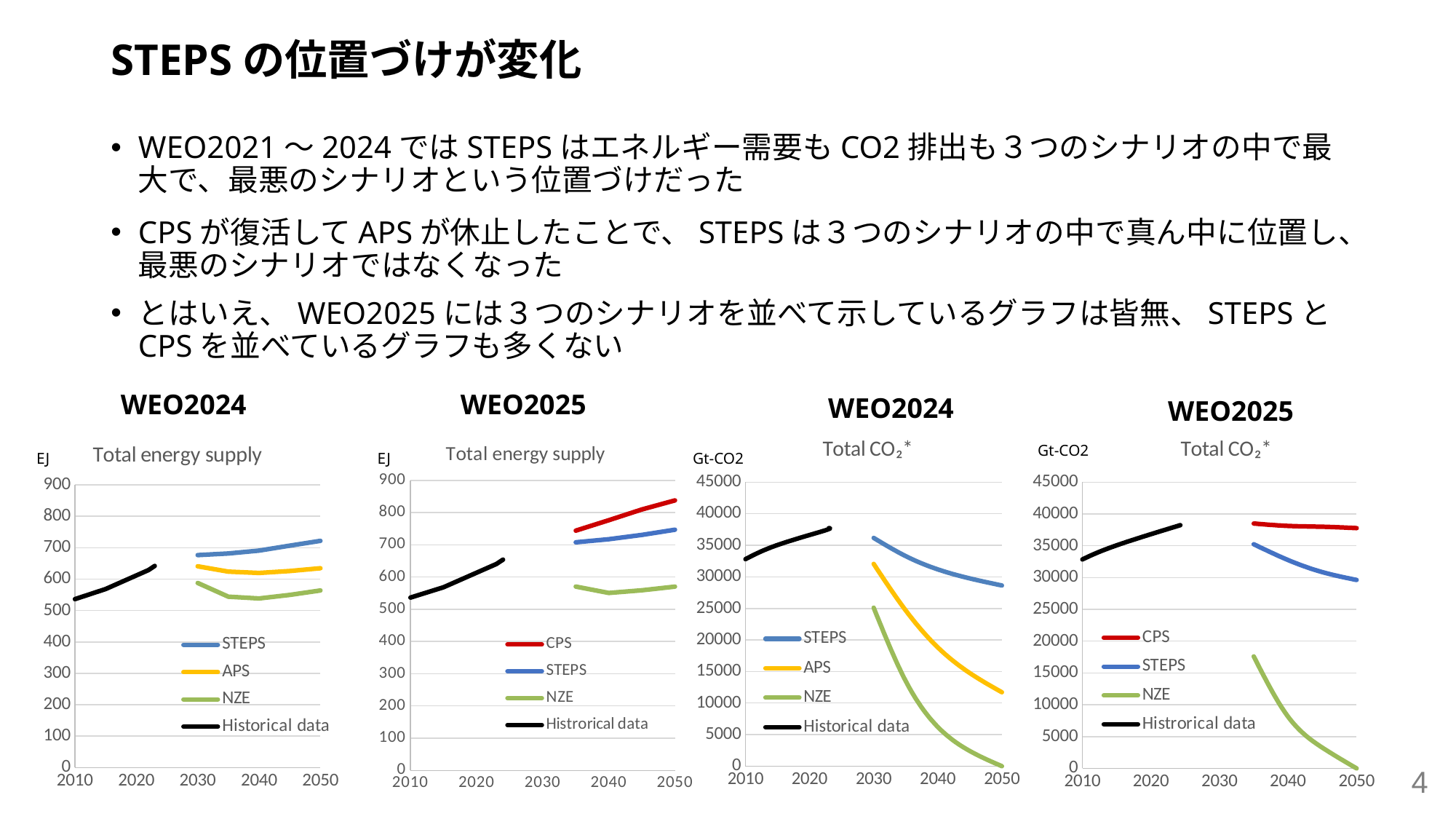
What kind of chart is the WEO2024 Total energy supply chart? line chart In the WEO2024 Total CO₂ chart, does the STEPS series rise or fall from 2030 to 2050? fall In the WEO2025 Total CO₂ chart, is the NZE value in 2050 greater or less than 5000? less Which series are listed in the legend of the WEO2025 Total CO₂ chart? CPS, STEPS, NZE, Histrorical data In the WEO2024 Total energy supply chart, is the NZE value in 2050 greater or less than 600? less In the WEO2025 Total energy supply chart, which series has the highest value in 2050? CPS In the WEO2025 Total CO₂ chart, which is larger in 2050, CPS or STEPS? CPS How many series does the legend of the WEO2025 Total energy supply chart list? 4 In the WEO2025 Total energy supply chart, is the CPS value in 2050 greater or less than 800? greater In the WEO2024 Total energy supply chart, which series has the lowest value in 2050? NZE What unit is shown on the y axis of the WEO2024 Total CO₂ chart? Gt-CO2